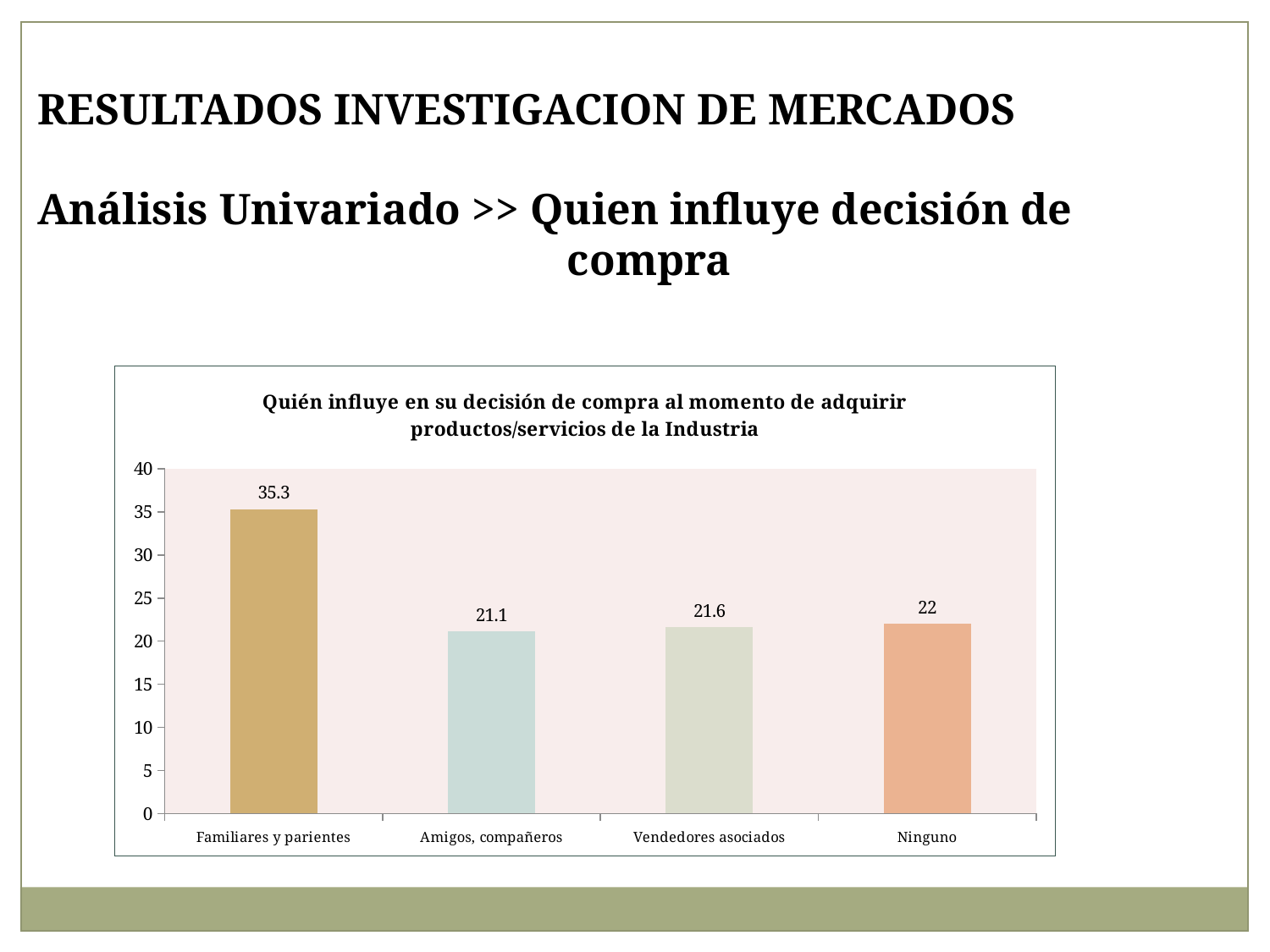
How many categories are shown on the x axis? 4 Which category has the lowest value? Amigos, compañeros What is the value for Familiares y parientes? 35.3 Is the value for Ninguno greater or less than 25? less What is the difference between the values for Vendedores asociados and Amigos, compañeros? 0.5 What is the value for Amigos, compañeros? 21.1 What kind of chart is shown on the slide? bar chart Which is larger, the value for Familiares y parientes or the value for Vendedores asociados? Familiares y parientes What is the value for Vendedores asociados? 21.6 What is the difference between the values for Familiares y parientes and Ninguno? 13.3 Which category has the highest value? Familiares y parientes What is the value for Ninguno? 22